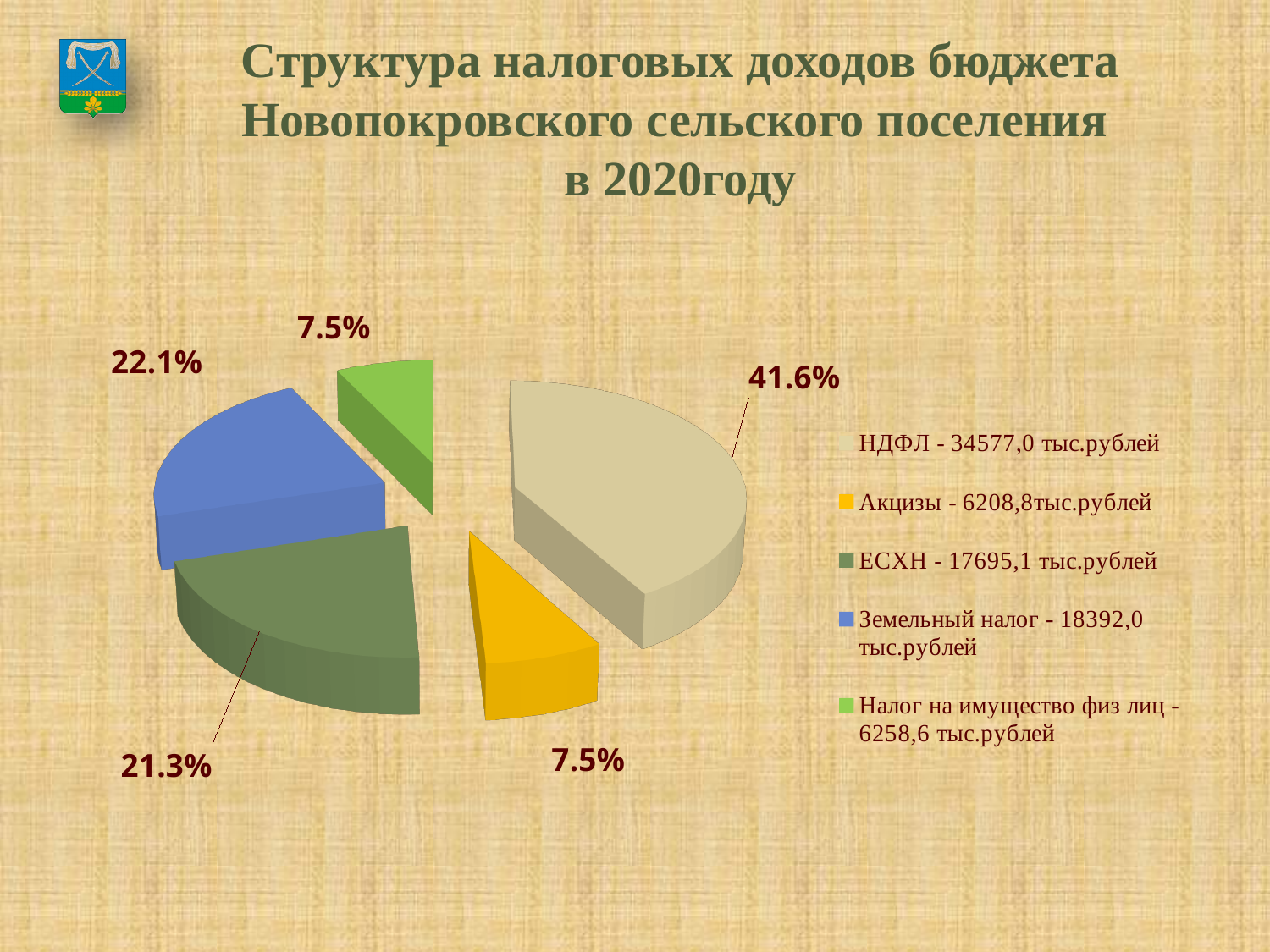
What share of the pie does ЕСХН represent? 21.3% What share of the pie does НДФЛ represent? 41.6% What is the amount shown in the legend for Налог на имущество физ лиц? 6258,6 тыс.рублей What is the amount shown in the legend for ЕСХН? 17695,1 тыс.рублей What share of the pie does Акцизы represent? 7.5% Which is larger, the share for Земельный налог or the share for ЕСХН? Земельный налог How many slices does the pie chart have? 5 What is the difference in percentage points between the НДФЛ share and the Земельный налог share? 19.5 What is the amount shown in the legend for Земельный налог? 18392,0 тыс.рублей What kind of chart is shown on the slide? pie chart Which category has the largest slice of the pie? НДФЛ